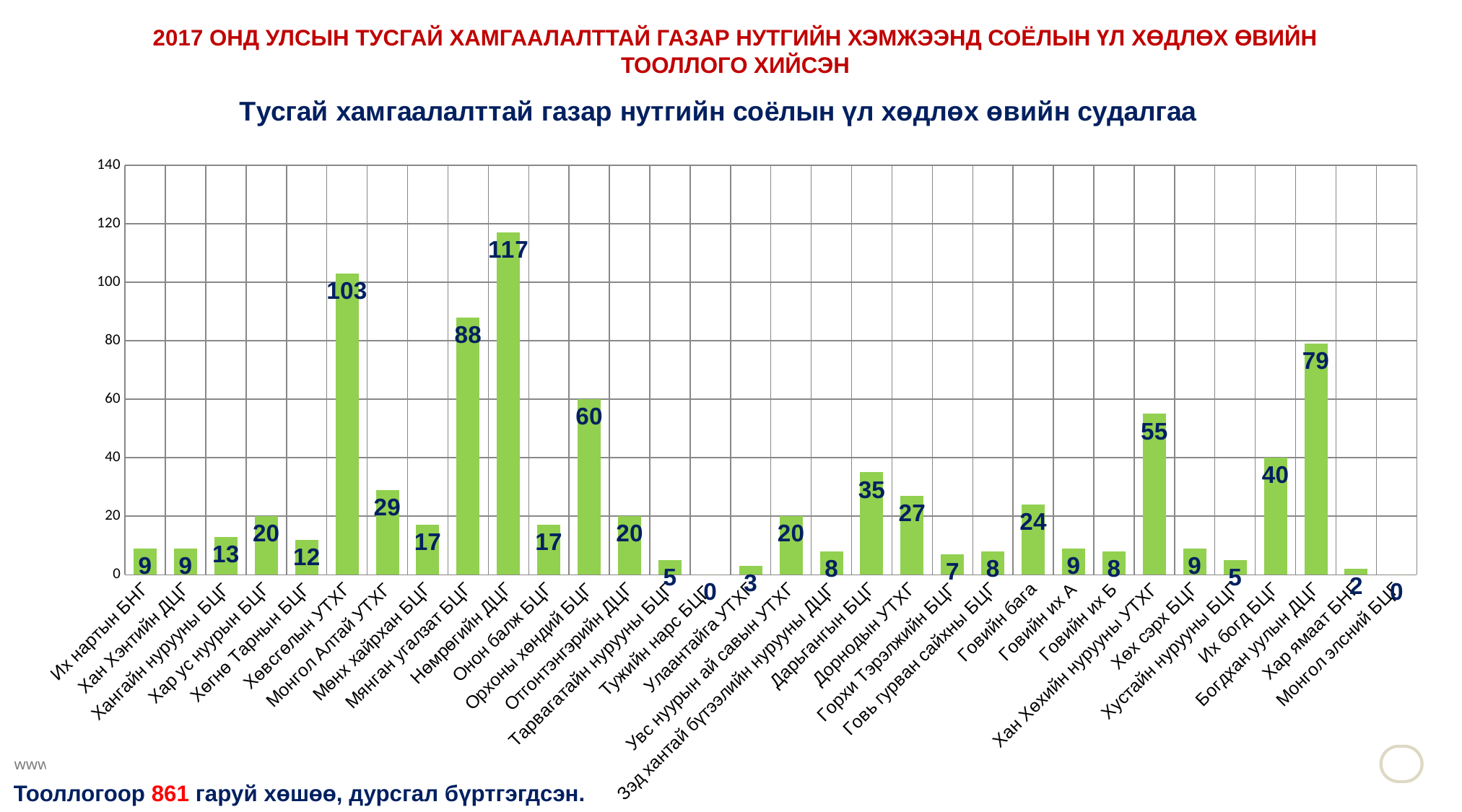
Is the value for Их богд БЦГ greater or less than 60? less Which is larger, the value for Орхоны хөндий БЦГ or the value for Хан Хөхийн нурууны УТХГ? Орхоны хөндий БЦГ What is the value for Дарьгангын БЦГ? 35 What is the value for Нөмрөгийн ДЦГ? 117 What is the value for Богдхан уулын ДЦГ? 79 What is the value for Хөвсгөлийн УТХГ? 103 How many categories are shown in the chart? 32 What is the title of the chart? Тусгай хамгаалалттай газар нутгийн соёлын үл хөдлөх өвийн судалгаа What is the difference between the values for Нөмрөгийн ДЦГ and Мянган угалзат БЦГ? 29 What is the lowest value shown in the chart? 0 Which category has the highest value? Нөмрөгийн ДЦГ What type of chart is shown on the slide? bar chart